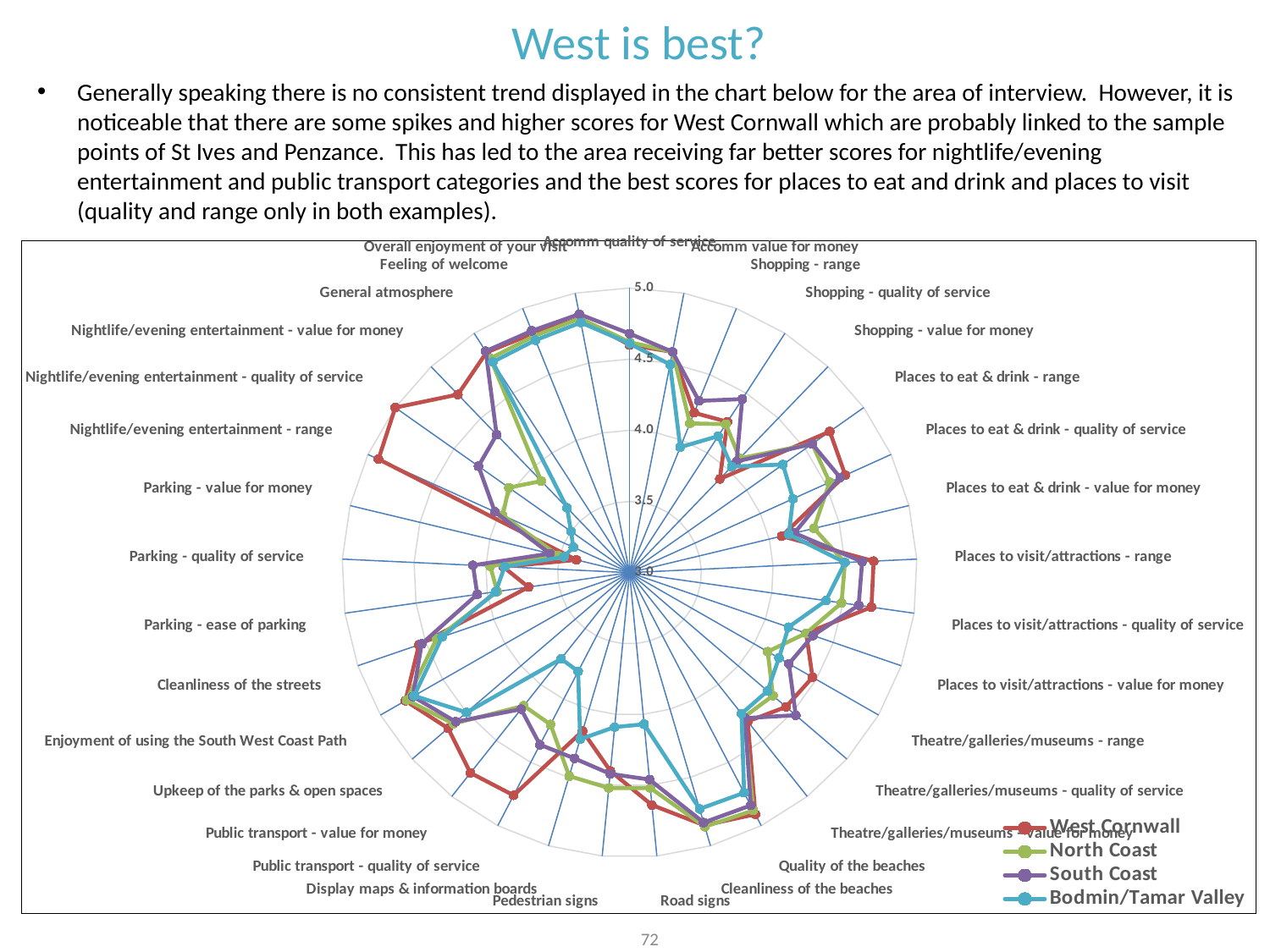
Is the West Cornwall value for Nightlife/evening entertainment - range greater or less than 4.5? greater Is the Bodmin/Tamar Valley value for Nightlife/evening entertainment - range greater or less than 4.0? less What kind of chart is shown on the slide? radar chart Which series has the higher value for Places to eat & drink - quality of service, West Cornwall or Bodmin/Tamar Valley? West Cornwall Which series is shown in red in the chart? West Cornwall Is the West Cornwall value for Parking - ease of parking greater or less than 4.0? less Which series is shown in blue in the chart? Bodmin/Tamar Valley How many series does the chart legend list? 4 Which series has the higher value for Theatre/galleries/museums - range, South Coast or Bodmin/Tamar Valley? South Coast Which series has the higher value for Nightlife/evening entertainment - quality of service, West Cornwall or Bodmin/Tamar Valley? West Cornwall